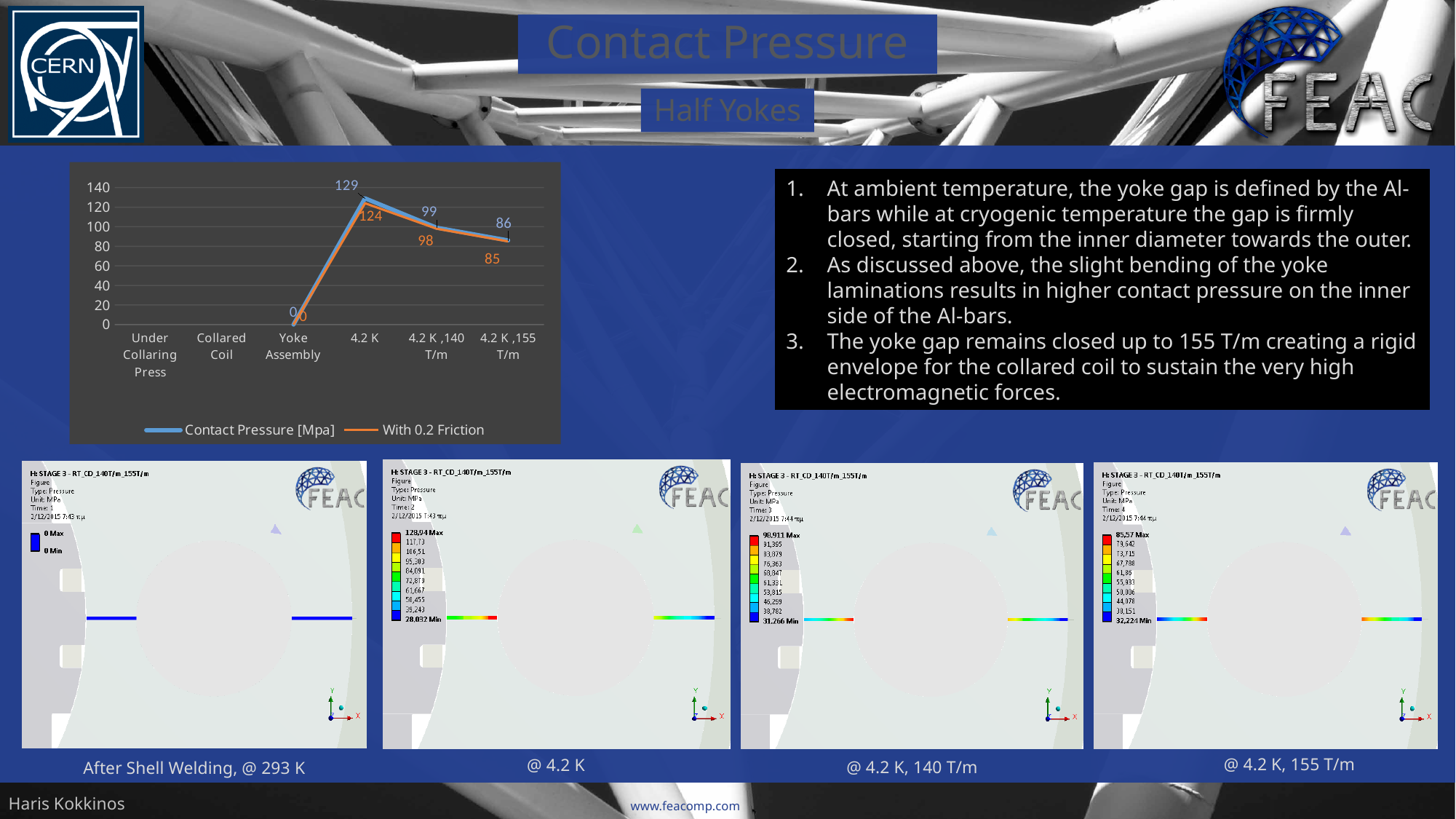
How many series does the chart legend list? 2 What is the Contact Pressure [Mpa] value at 4.2 K ,140 T/m? 99 How many categories are labelled on the x axis of the chart? 6 What is the difference between the Contact Pressure [Mpa] value and the With 0.2 Friction value at 4.2 K? 5 Which is larger at 4.2 K ,140 T/m: the Contact Pressure [Mpa] value or the With 0.2 Friction value? Contact Pressure [Mpa] What type of chart is shown on the slide? line chart What is the With 0.2 Friction value at 4.2 K ,155 T/m? 85 What is the With 0.2 Friction value at 4.2 K? 124 What is the Contact Pressure [Mpa] value at 4.2 K? 129 Does the Contact Pressure [Mpa] series rise or fall from 4.2 K to 4.2 K ,155 T/m? fall At which category does the Contact Pressure [Mpa] series reach its highest value? 4.2 K What is the difference between the Contact Pressure [Mpa] values at 4.2 K and at 4.2 K ,155 T/m? 43